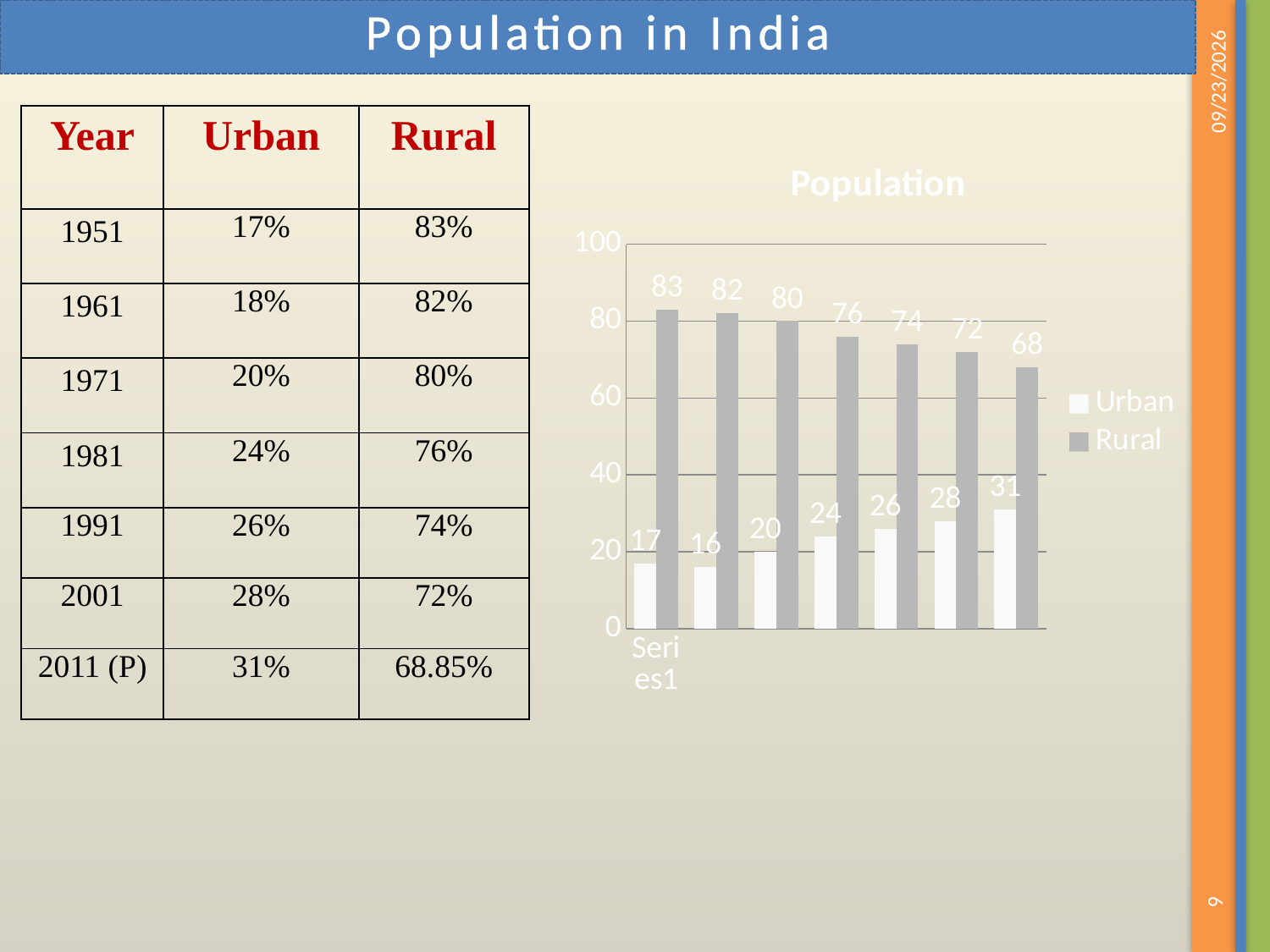
How many series does the chart's legend list? 2 What is the Rural value for the first group (Series1) in the chart? 83 Do the Rural values rise or fall from left to right across the chart? fall What is the highest Rural value labelled in the chart? 83 What is the Urban value for the first group (Series1) in the chart? 17 What is the difference between the Rural and Urban values for the first group (Series1)? 66 What kind of chart is shown on the slide? bar chart How many groups of bars are plotted in the chart? 7 What are the two entries in the chart's legend? Urban, Rural For the first group (Series1), which is larger, the Urban bar or the Rural bar? Rural What is the title of the chart? Population What is the lowest Urban value labelled in the chart? 16